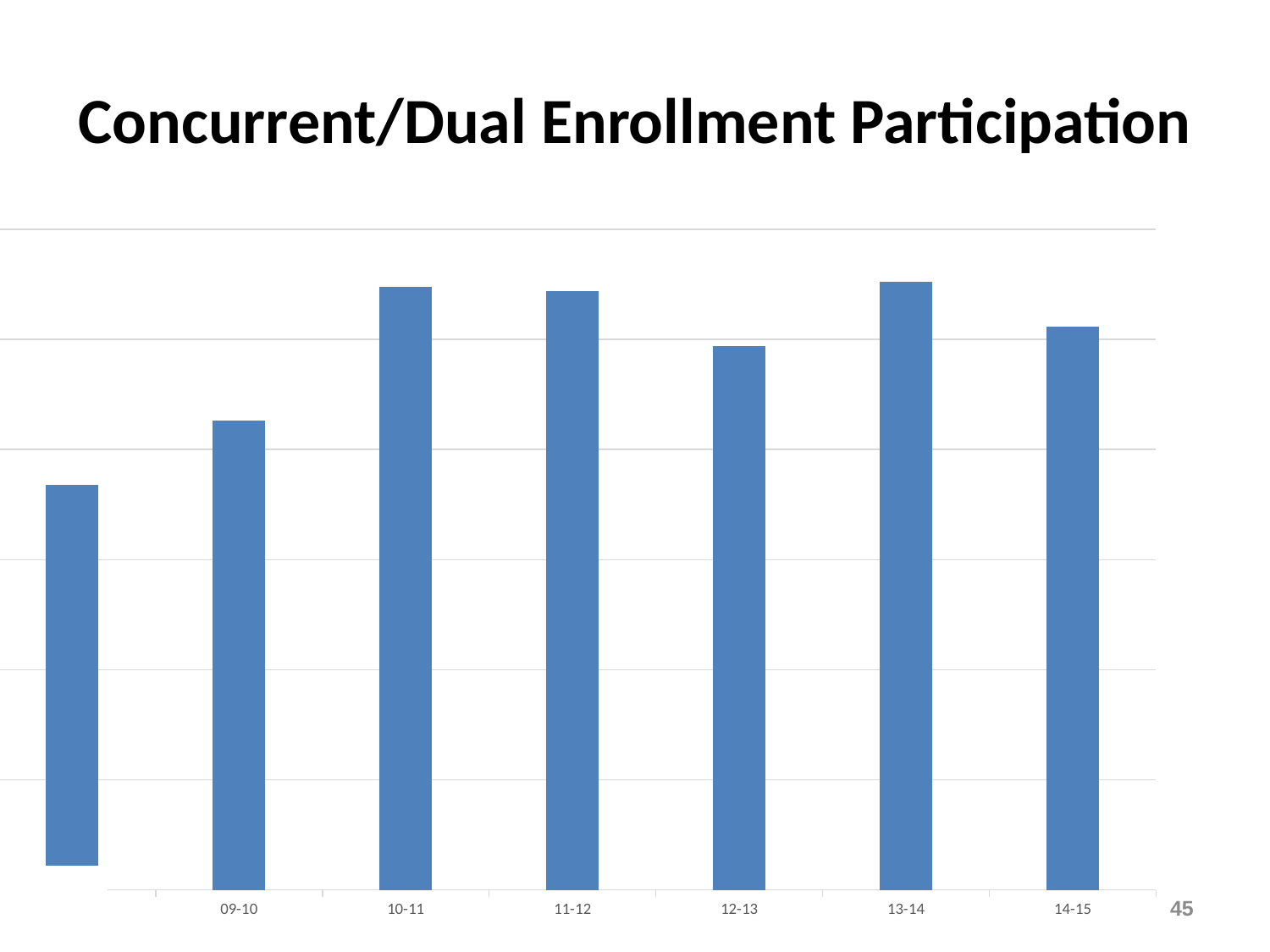
What colour are the bars in the chart? blue What is the title of the slide? Concurrent/Dual Enrollment Participation Which is larger, the value for 09-10 or the value for 14-15? 14-15 Which is larger, the value for 12-13 or the value for 13-14? 13-14 Which is larger, the value for 11-12 or the value for 12-13? 11-12 Does the value rise or fall from 11-12 to 12-13? fall How many bars are plotted in the chart? 7 Does the value rise or fall from 13-14 to 14-15? fall Does the value rise or fall from 09-10 to 10-11? rise What kind of chart is shown on the slide? bar chart